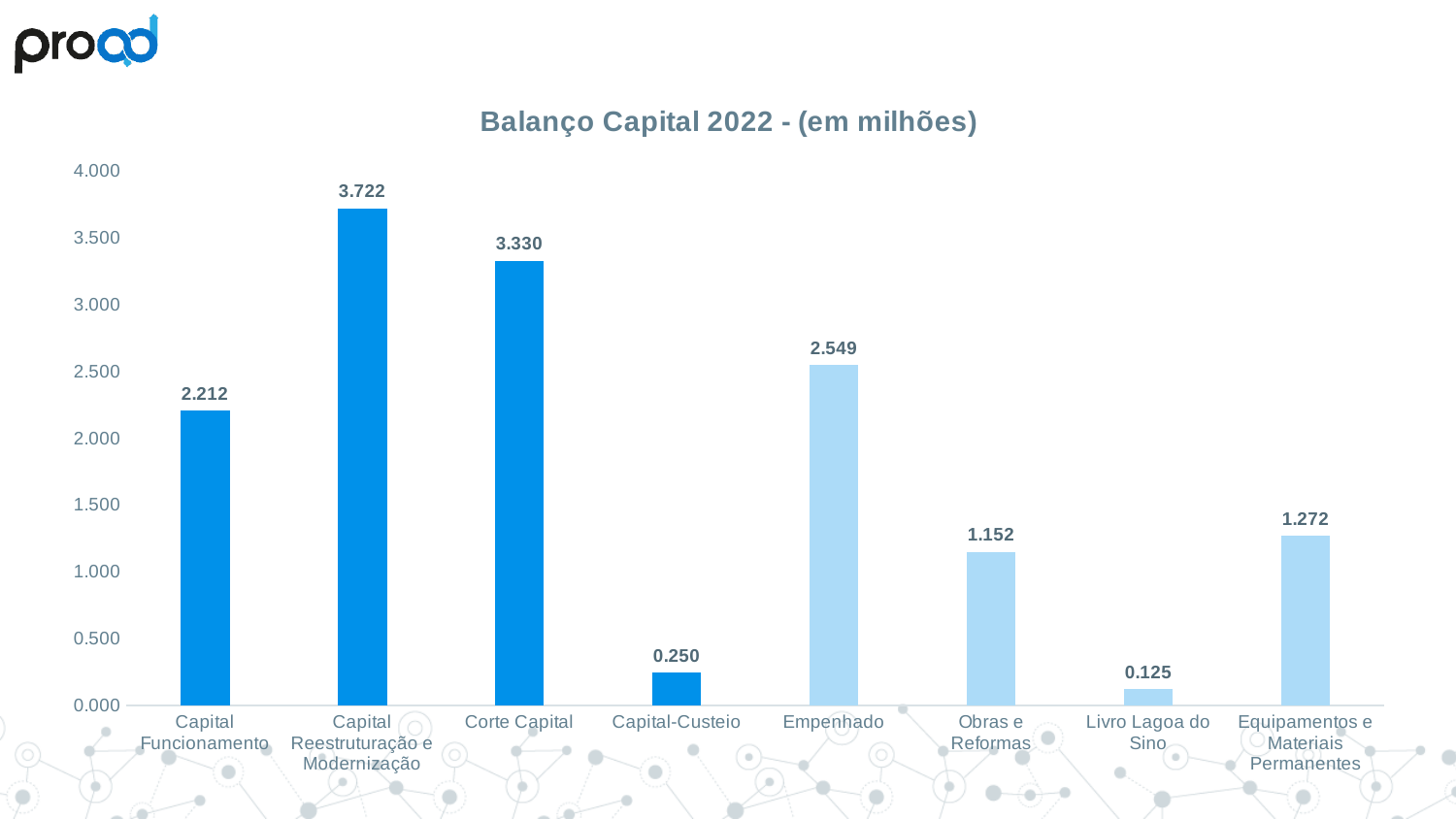
What is the value for Livro Lagoa do Sino? 0.125 What is the title of the chart? Balanço Capital 2022 - (em milhões) What is the difference between Empenhado and Obras e Reformas? 1.397 Which category has the lowest value? Livro Lagoa do Sino What is the value for Empenhado? 2.549 What is the value for Equipamentos e Materiais Permanentes? 1.272 What is the value for Capital Funcionamento? 2.212 What is the difference between Capital Reestruturação e Modernização and Corte Capital? 0.392 Which category has the highest value? Capital Reestruturação e Modernização How many categories are shown in the chart? 8 What kind of chart is shown on the slide? Bar chart Which is larger, Obras e Reformas or Equipamentos e Materiais Permanentes? Equipamentos e Materiais Permanentes